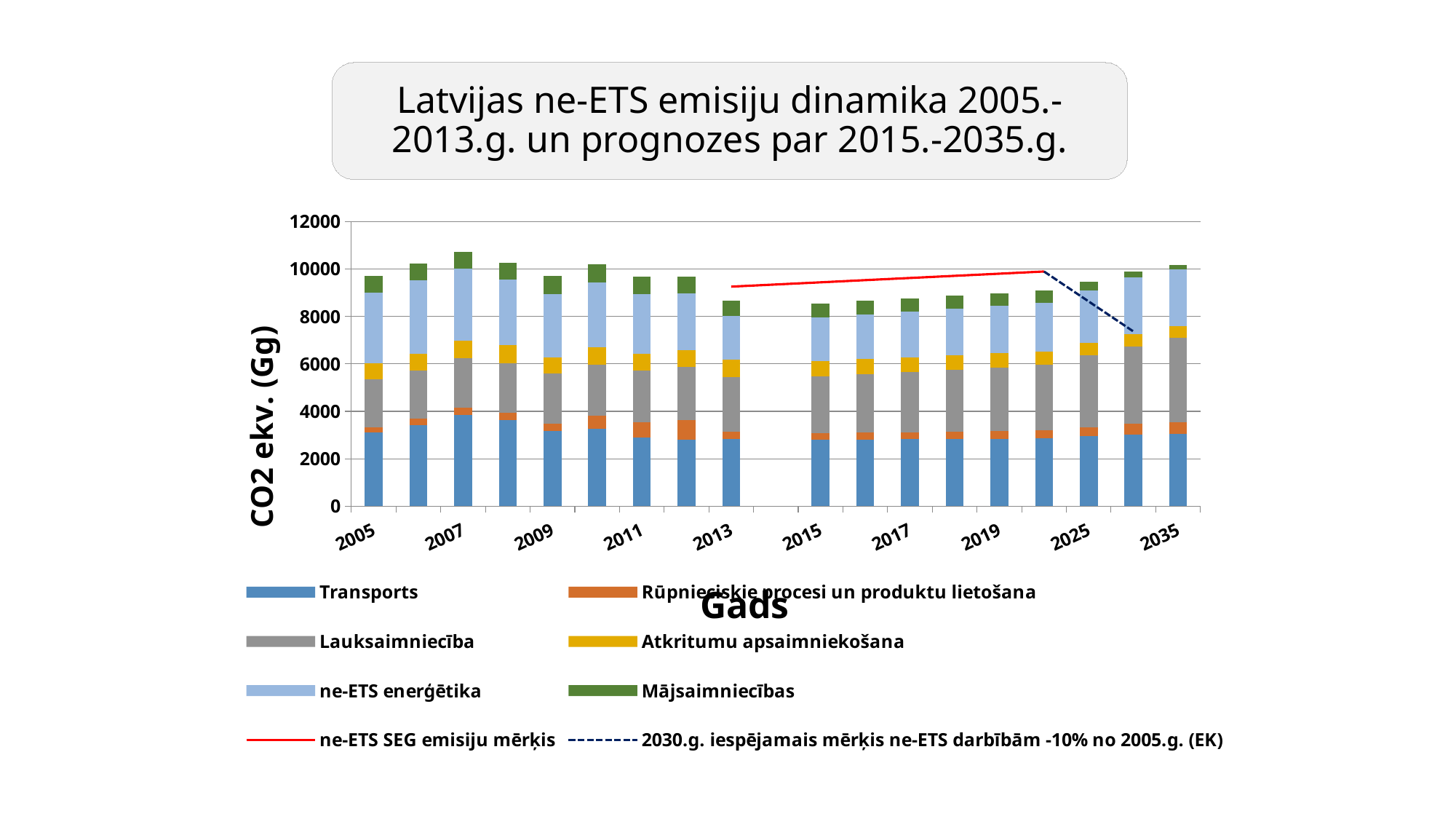
Is the total stacked value for 2007 greater or less than 10000? greater Which year has the larger total stacked bar, 2007 or 2013? 2007 Which series does the solid red line represent? ne-ETS SEG emisiju mērķis Which year has the tallest stacked bar? 2007 What kind of chart is shown on the slide? Combination stacked bar and line chart How many bars (years) are plotted in the chart? 18 How many entries does the chart legend list? 8 Is the total stacked value for 2005 greater or less than 10000? less What is the label of the vertical axis? CO2 ekv. (Gg) Do the total stacked bar values rise or fall from 2015 to 2035? rise Is the total stacked value for 2015 greater or less than 10000? less